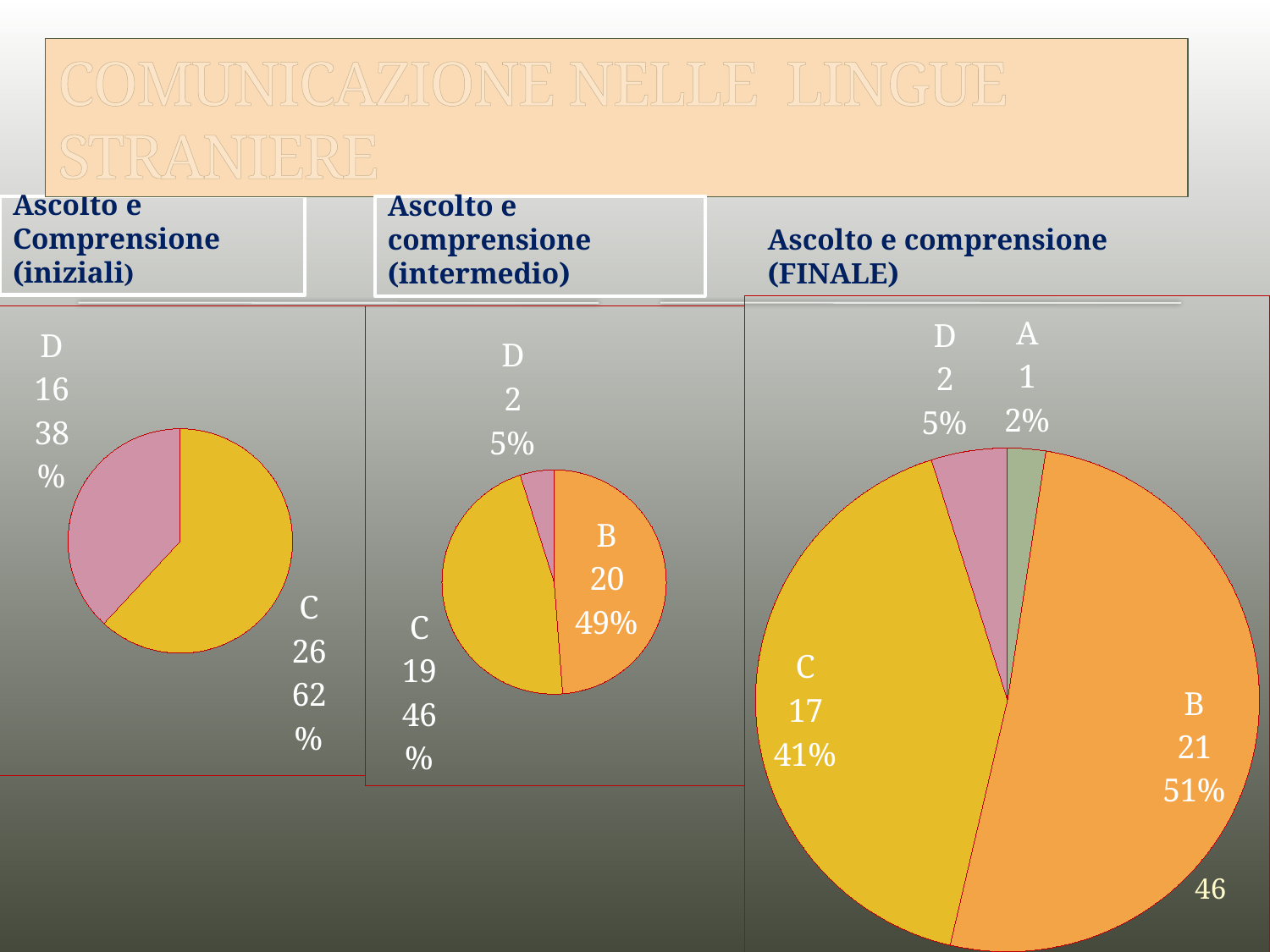
In the 'Ascolto e comprensione (intermedio)' chart, what is the value for B? 20 In the 'Ascolto e comprensione (FINALE)' chart, what is the value for B? 21 In the 'Ascolto e Comprensione (iniziali)' chart, how many slices are there? 2 In the 'Ascolto e Comprensione (iniziali)' chart, what share of the pie does D have? 38% In the 'Ascolto e comprensione (intermedio)' chart, which category has the smallest slice? D In the 'Ascolto e comprensione (FINALE)' chart, what is the difference between the values for B and C? 4 In the 'Ascolto e comprensione (FINALE)' chart, how many slices are there? 4 In the 'Ascolto e comprensione (FINALE)' chart, what share of the pie does A have? 2% In the 'Ascolto e comprensione (FINALE)' chart, which category has the largest slice? B In the 'Ascolto e comprensione (intermedio)' chart, what share of the pie does C have? 46% What kind of chart is used for 'Ascolto e Comprensione (iniziali)'? pie chart In the 'Ascolto e Comprensione (iniziali)' chart, what is the value for C? 26